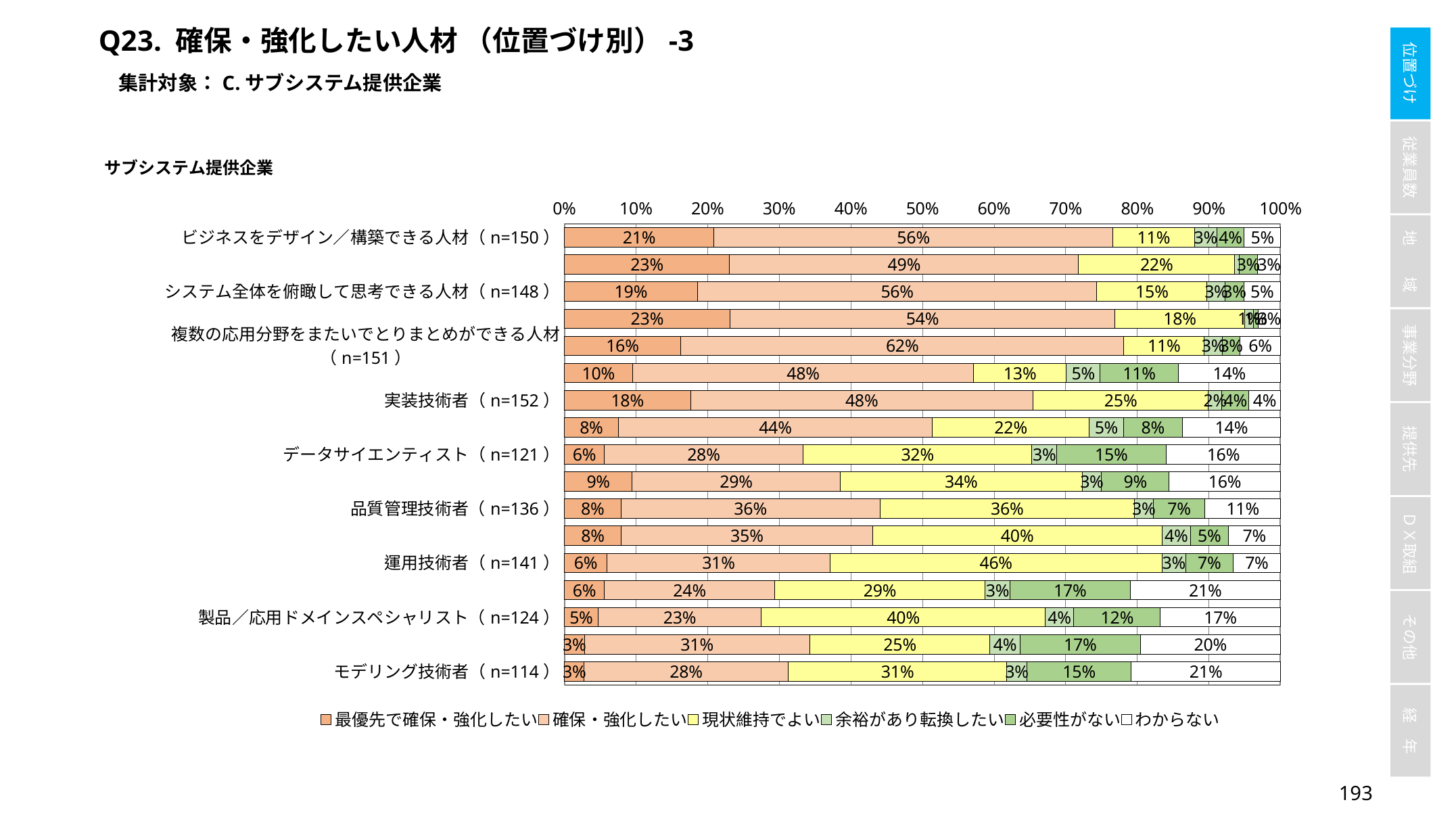
What is the difference between the 確保・強化したい values for 実装技術者 (n=152) and 製品／応用ドメインスペシャリスト (n=124)? 25% Among the labelled categories, which has the lowest value for 最優先で確保・強化したい? モデリング技術者 (n=114) What is the combined value of 最優先で確保・強化したい and 確保・強化したい for システム全体を俯瞰して思考できる人材 (n=148)? 75% What is the value of わからない for モデリング技術者 (n=114)? 21% What is the value of 必要性がない for データサイエンティスト (n=121)? 15% What kind of chart is shown on the slide? Stacked bar chart How many series does the legend list? 6 What is the value of 最優先で確保・強化したい for ビジネスをデザイン／構築できる人材 (n=150)? 21% Among the labelled categories, which has the highest value for 最優先で確保・強化したい? ビジネスをデザイン／構築できる人材 (n=150) What is the value of 確保・強化したい for 複数の応用分野をまたいでとりまとめができる人材 (n=151)? 62% What is the value of 現状維持でよい for 運用技術者 (n=141)? 46% Which is larger: the 現状維持でよい value for 品質管理技術者 (n=136) or for 実装技術者 (n=152)? 品質管理技術者 (n=136)